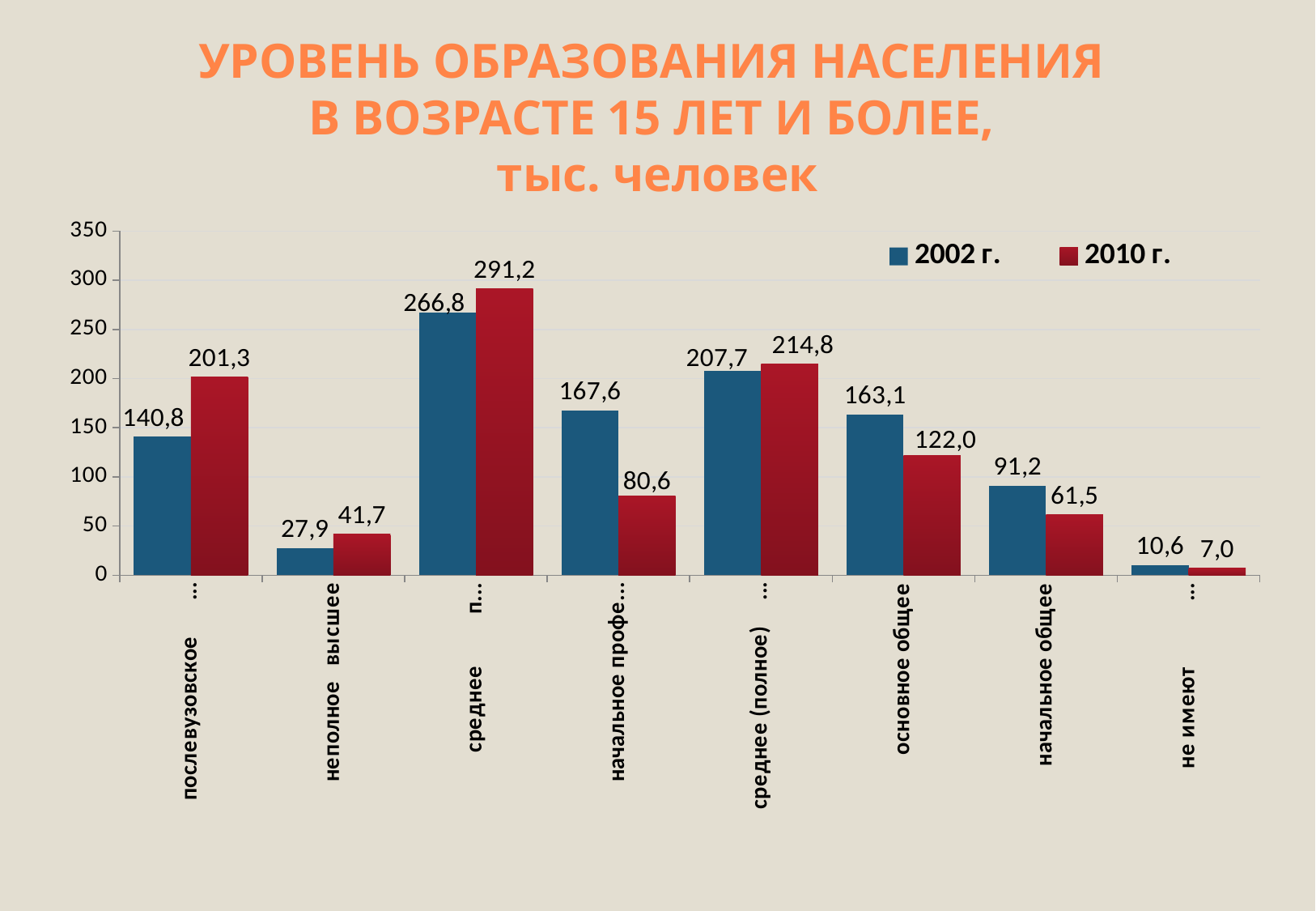
Which category has the lowest value for 2002 г.? не имеют How many series does the legend list? 2 What is the value for 'основное общее' in 2002 г.? 163,1 What is the value for 'послевузовское' in 2010 г.? 201,3 How many education categories are shown on the x axis? 8 What is the value for 'неполное высшее' in 2002 г.? 27,9 What kind of chart is shown on the slide? bar chart What is the difference between the 2002 г. and 2010 г. values for 'основное общее'? 41,1 What is the value for 'не имеют' in 2010 г.? 7,0 What is the highest value shown for the 2010 г. series? 291,2 By how much did the value for 'послевузовское' increase from 2002 г. to 2010 г.? 60,5 For 'начальное общее', which year has the larger value, 2002 г. or 2010 г.? 2002 г.